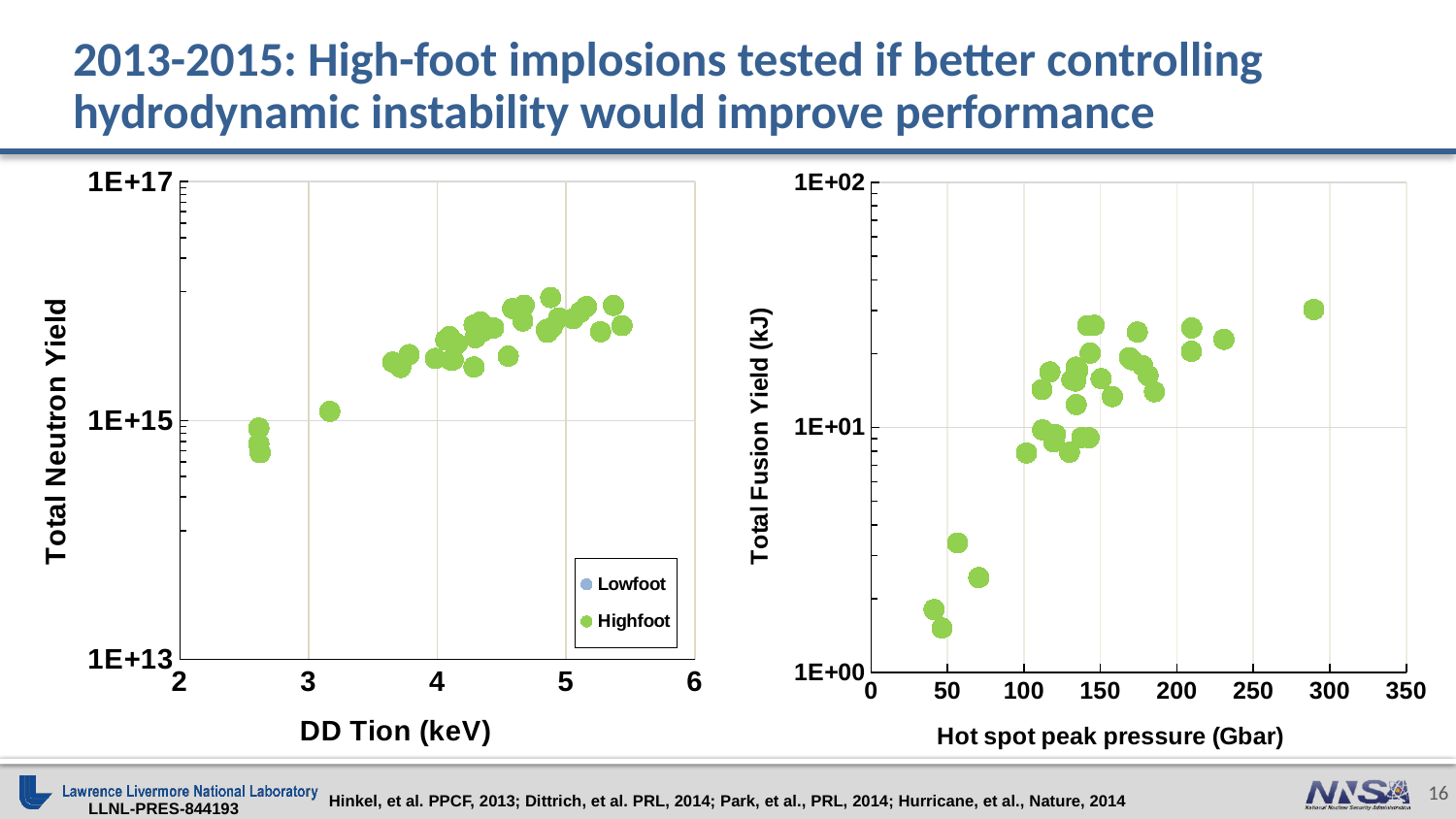
In the right chart, is the Hot spot peak pressure of the rightmost point greater or less than 250 Gbar? greater In the left chart, is the Total Neutron Yield for the points at a DD Tion of about 2.6 keV greater or less than 1E+15? less In the right chart, does Total Fusion Yield generally rise or fall as Hot spot peak pressure increases? rise In the left chart, is the Total Neutron Yield for the points at a DD Tion of about 5 keV greater or less than 1E+15? greater How many series does the legend of the left chart list? 2 In the left chart, do the Total Neutron Yield values generally rise or fall as DD Tion increases? rise What kind of chart is the left chart (Total Neutron Yield vs DD Tion)? scatter chart What is the x-axis title of the right chart? Hot spot peak pressure (Gbar) What are the two series named in the legend of the left chart? Lowfoot and Highfoot What kind of chart is the right chart (Total Fusion Yield vs Hot spot peak pressure)? scatter chart